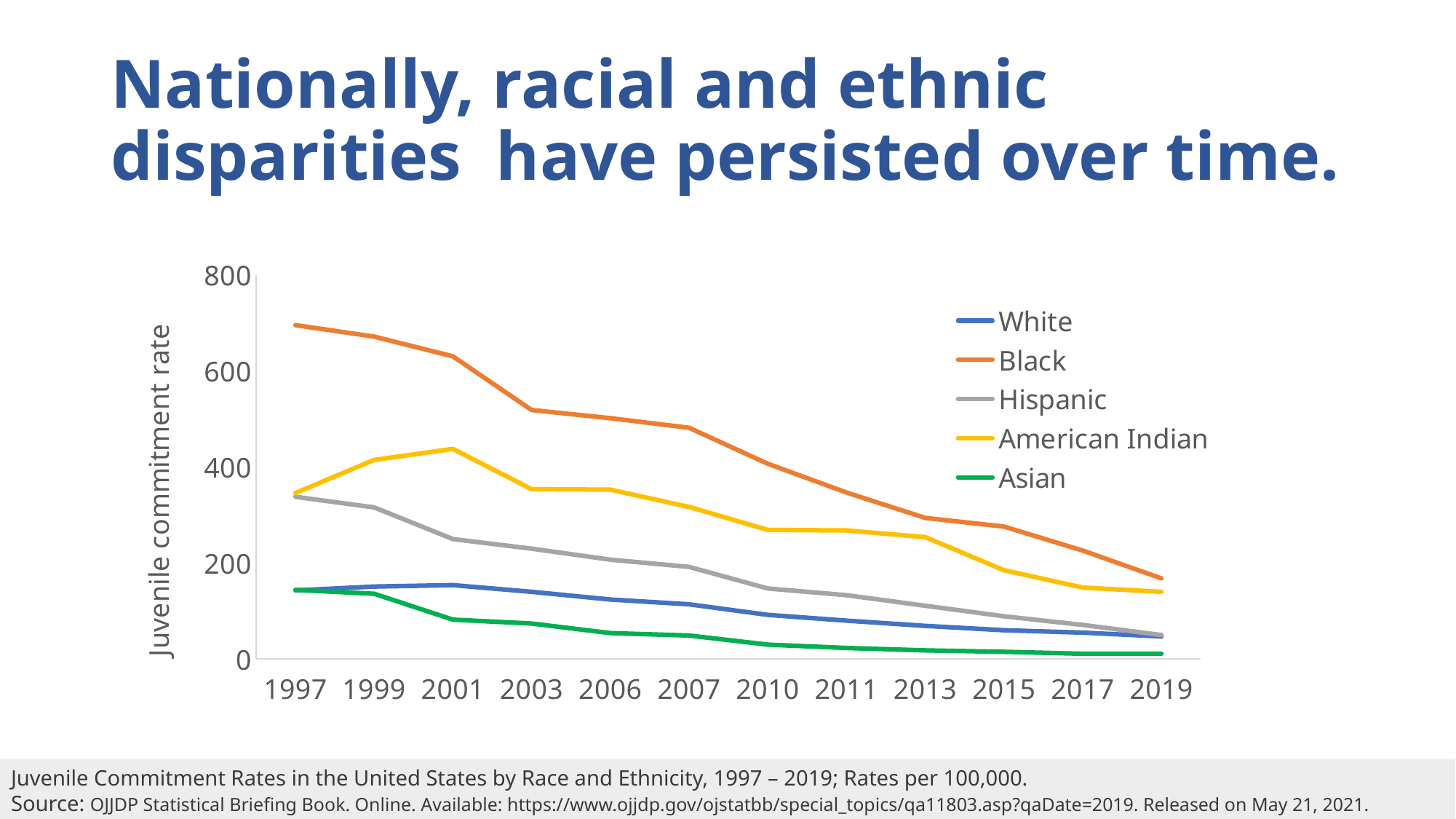
Does the juvenile commitment rate for Black youth rise or fall from 1997 to 2019? fall Which series has the lowest juvenile commitment rate in 2019? Asian Which series is drawn in green? Asian How many years are shown along the x axis? 12 Is the value for American Indian in 2001 greater or less than 400? greater Is the value for Black in 1997 greater or less than 600? greater Which series has the highest juvenile commitment rate in 1997? Black What kind of chart is shown on the slide? line chart Is the value for Hispanic in 2019 greater or less than 200? less Which is larger in 2007, the value for Black or the value for White? Black How many series does the legend list? 5 What is the label on the y axis? Juvenile commitment rate